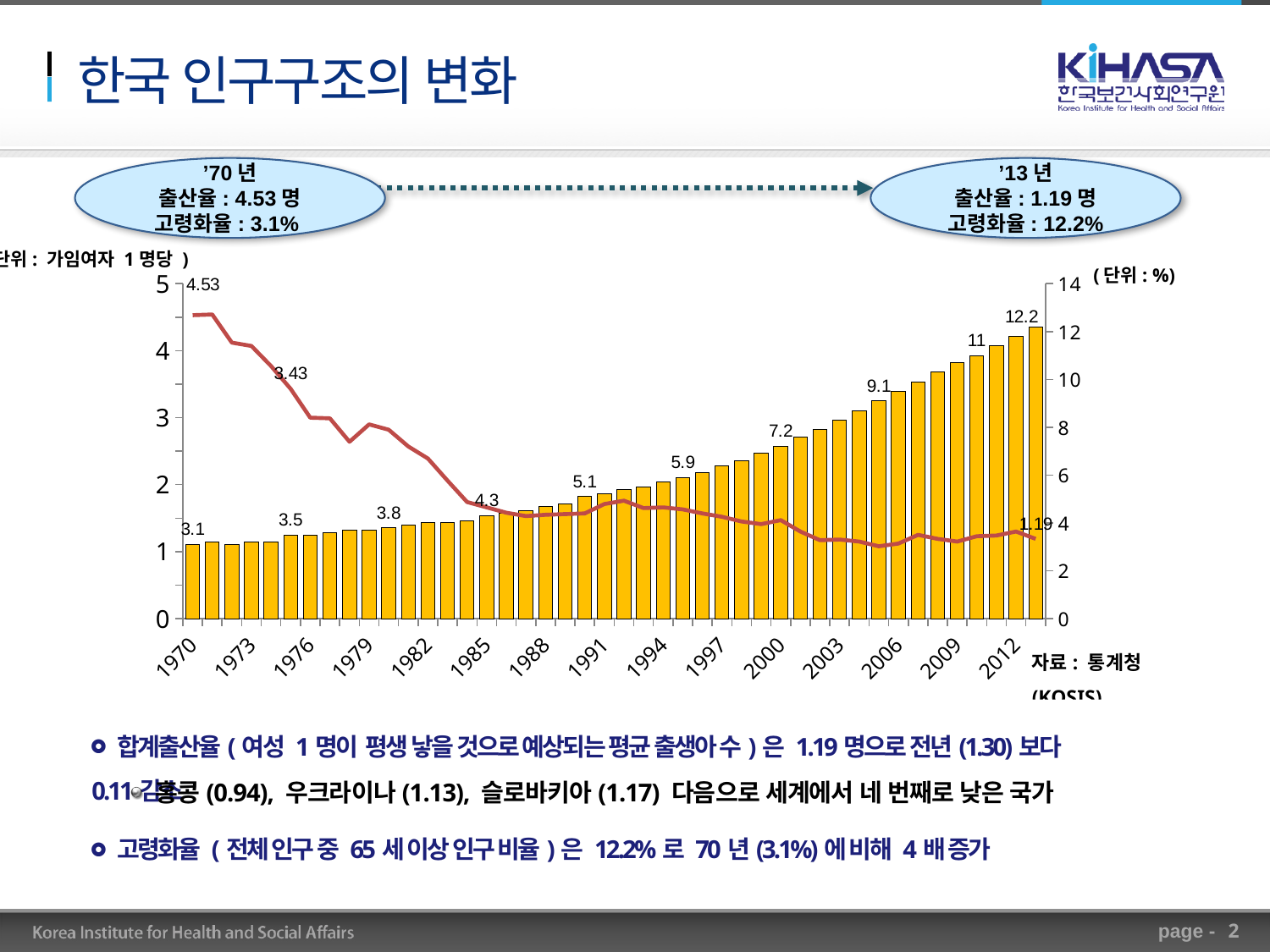
What is the value of the bar for 2000? 7.2 Which year has the tallest bar? 2013 What is the difference between the bar values for 2013 and 1970? 9.1 What is the value of the bar for 1970 (the aging rate, right axis)? 3.1 Is the value of the line (fertility rate) at 1990 greater or less than 2? less What kind of chart is shown on the slide? A combination bar and line chart Does the line (fertility rate) rise or fall from 1970 to 2013? Fall What is the value of the line (fertility rate) at 1970? 4.53 What is the value of the bar for 2005? 9.1 Do the bar values rise or fall from 1970 to 2013? Rise What is the value of the line (fertility rate) at 2013? 1.19 What is the value of the bar for 2013 (the aging rate, right axis)? 12.2